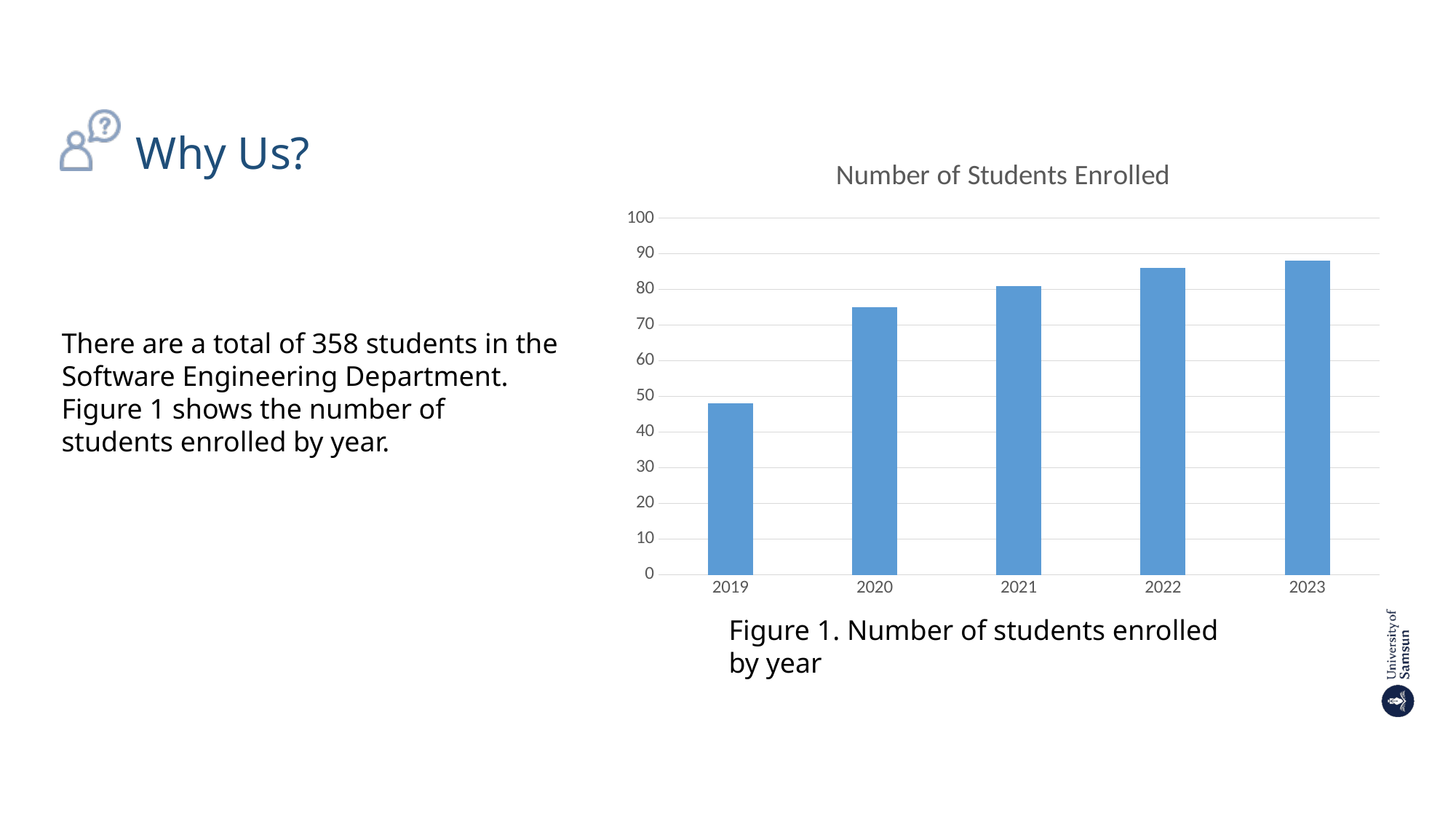
What kind of chart is shown on the slide? Bar chart Is the value for 2023 greater or less than 90? less Which year has the lowest number of students enrolled? 2019 Is the value for 2021 greater or less than 70? greater Is the value for 2020 greater or less than 70? greater Do the values rise or fall from 2019 to 2023? Rise Which year has more students enrolled, 2021 or 2019? 2021 Which year has more students enrolled, 2019 or 2020? 2020 How many years are shown on the x axis of the chart? 5 What is the title of the chart? Number of Students Enrolled